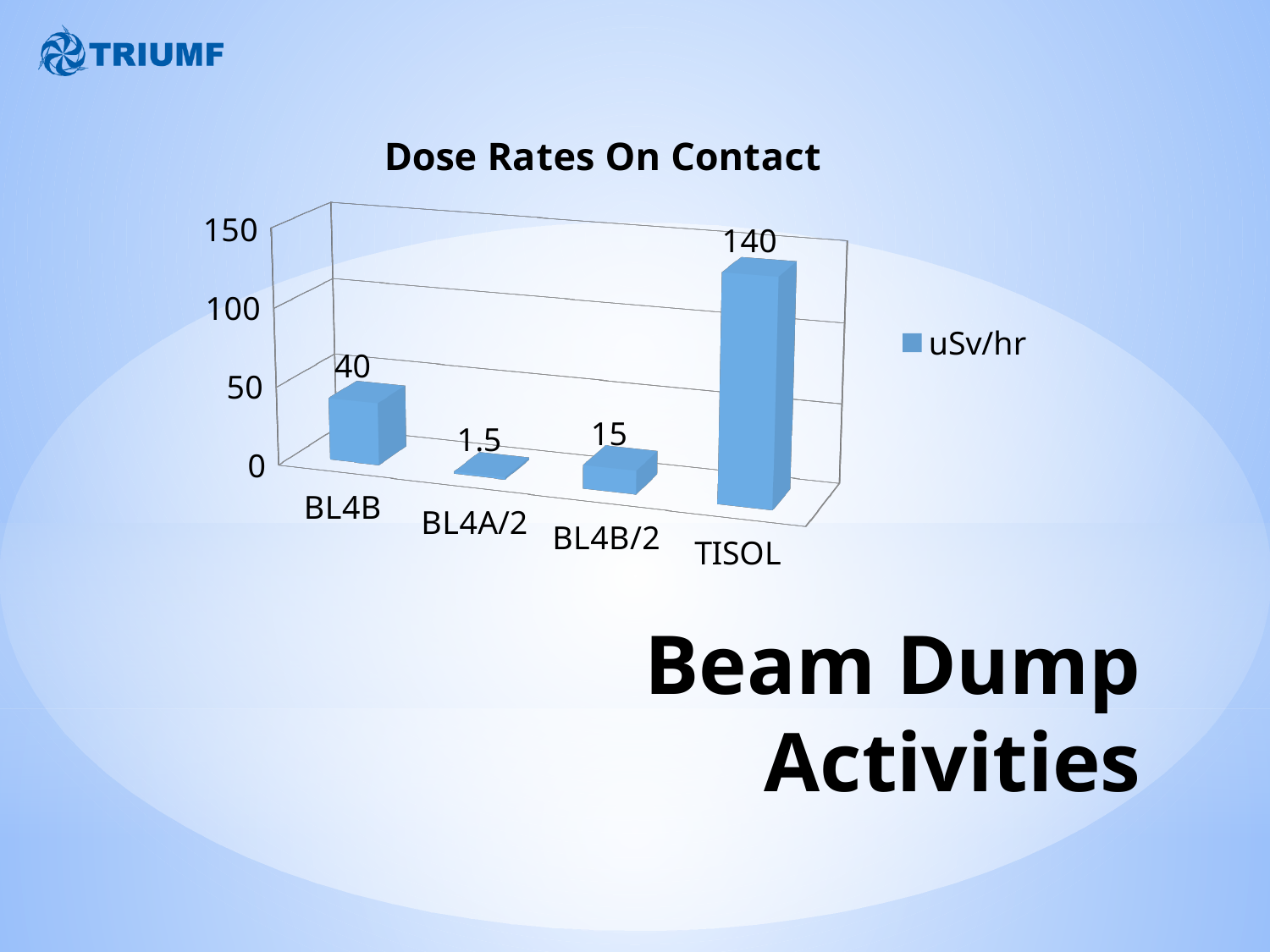
What is the title of the chart? Dose Rates On Contact Which category has the highest dose rate on contact? TISOL What is the dose rate on contact for TISOL? 140 What kind of chart is shown on the slide? bar chart What is the dose rate on contact for BL4B/2? 15 Which category has the lowest dose rate on contact? BL4A/2 Which has a higher dose rate on contact, BL4B or BL4B/2? BL4B Is the value for TISOL greater or less than 100? greater How many categories are shown in the chart? 4 What is the dose rate on contact for BL4A/2? 1.5 What is the dose rate on contact for BL4B? 40 What is the difference between the dose rates for TISOL and BL4B? 100